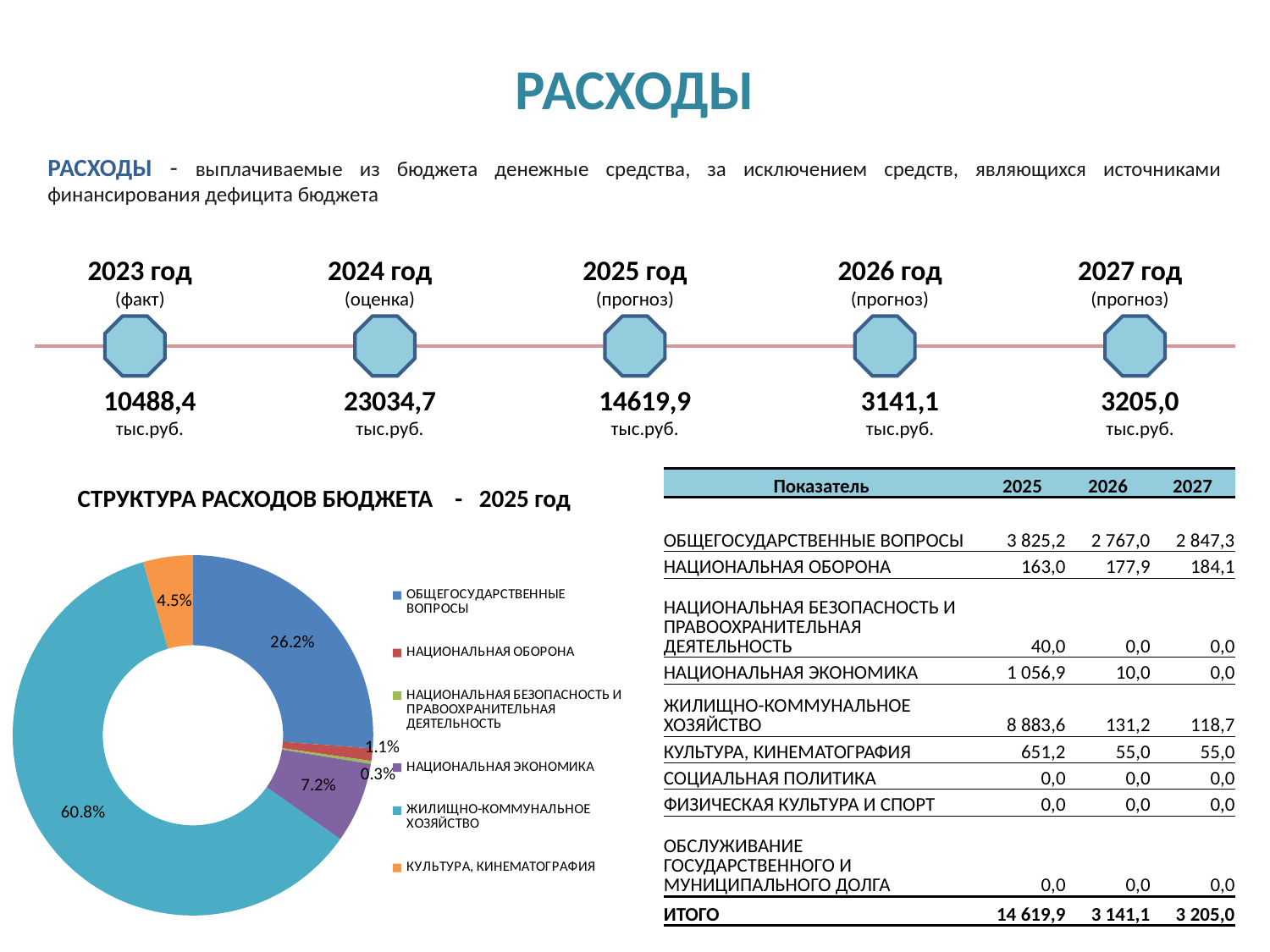
Which category has the largest share in the 2025 budget expenditure structure chart? ЖИЛИЩНО-КОММУНАЛЬНОЕ ХОЗЯЙСТВО What colour is the ЖИЛИЩНО-КОММУНАЛЬНОЕ ХОЗЯЙСТВО slice in the 2025 budget expenditure structure chart? Teal (light blue) What kind of chart is shown under the heading 'СТРУКТУРА РАСХОДОВ БЮДЖЕТА - 2025 год'? Doughnut (pie) chart In the 2025 budget expenditure structure chart, what is the difference in percentage points between ЖИЛИЩНО-КОММУНАЛЬНОЕ ХОЗЯЙСТВО and ОБЩЕГОСУДАРСТВЕННЫЕ ВОПРОСЫ? 34.6 percentage points What share of the 2025 budget expenditure structure is НАЦИОНАЛЬНАЯ ЭКОНОМИКА? 7.2% What share of the 2025 budget expenditure structure is КУЛЬТУРА, КИНЕМАТОГРАФИЯ? 4.5% In the 2025 budget expenditure structure chart, which has a larger share: НАЦИОНАЛЬНАЯ ЭКОНОМИКА or КУЛЬТУРА, КИНЕМАТОГРАФИЯ? НАЦИОНАЛЬНАЯ ЭКОНОМИКА How many categories does the legend of the 2025 budget expenditure structure chart list? 6 Which category has the smallest share in the 2025 budget expenditure structure chart? НАЦИОНАЛЬНАЯ БЕЗОПАСНОСТЬ И ПРАВООХРАНИТЕЛЬНАЯ ДЕЯТЕЛЬНОСТЬ What share of the 2025 budget expenditure structure is НАЦИОНАЛЬНАЯ ОБОРОНА? 1.1% What share of the 2025 budget expenditure structure is ОБЩЕГОСУДАРСТВЕННЫЕ ВОПРОСЫ? 26.2% What share of the 2025 budget expenditure structure is ЖИЛИЩНО-КОММУНАЛЬНОЕ ХОЗЯЙСТВО? 60.8%